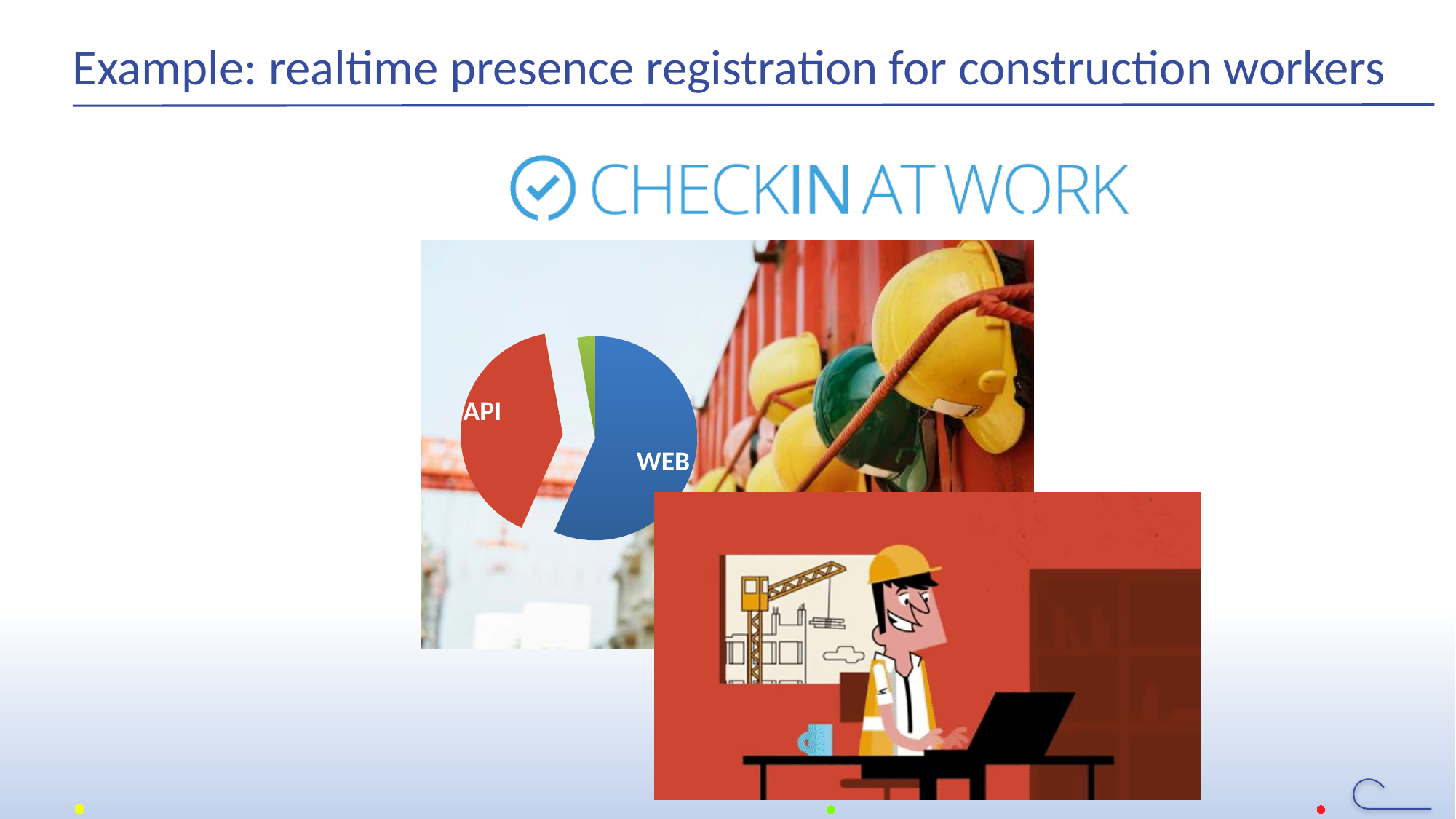
What colour is the API slice of the pie chart? red Which of the two labelled slices, API or WEB, is larger? WEB Which labelled slice of the pie chart is the largest? WEB How many slices does the pie chart have? 3 What kind of chart is shown on the slide? pie chart What colour is the smallest slice of the pie chart? green